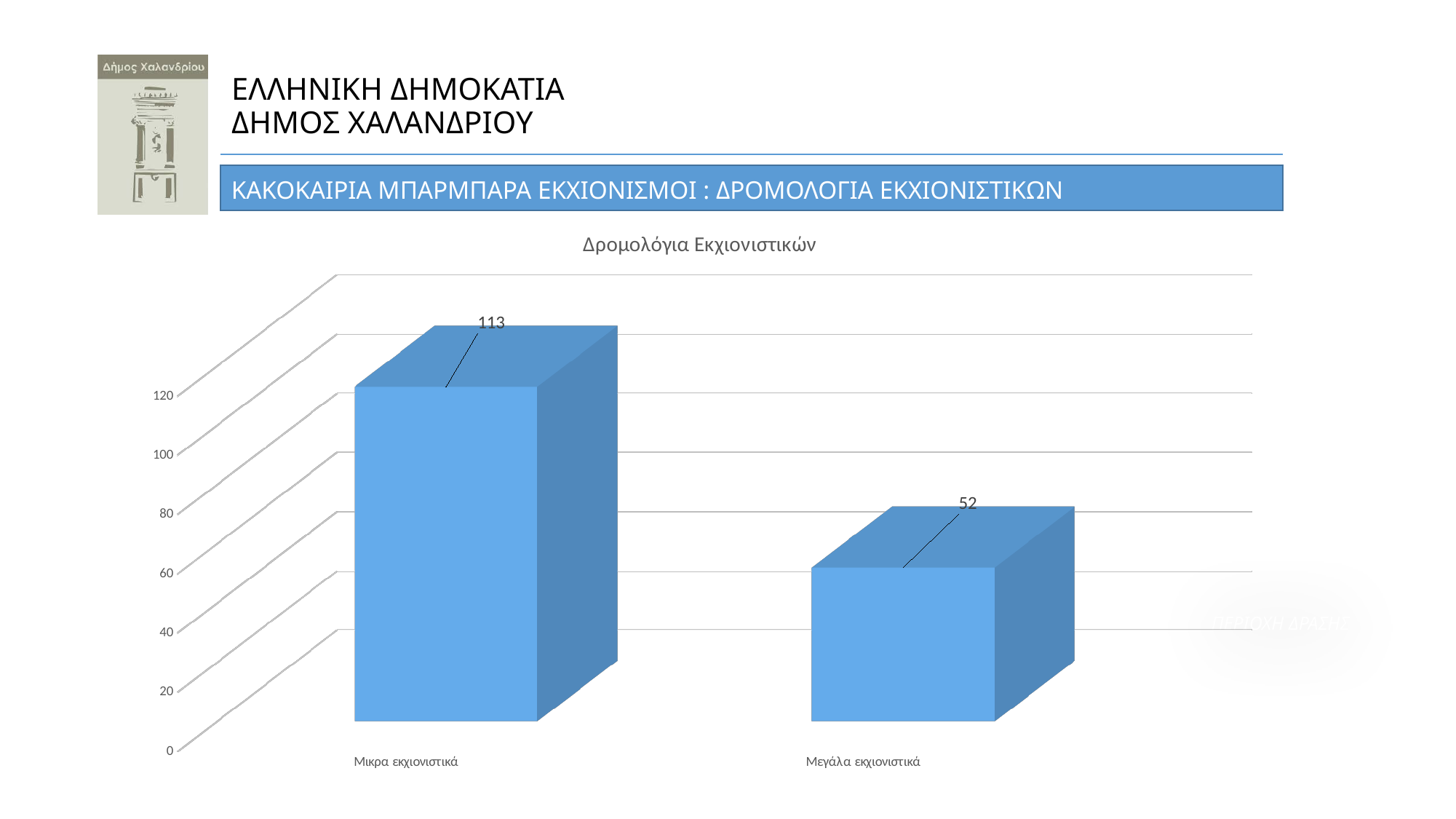
What is the value for Μικρα εκχιονιστικά? 113 What is the total of the two values shown in the chart? 165 What is the difference between the values for Μικρα εκχιονιστικά and Μεγάλα εκχιονιστικά? 61 What kind of chart is shown on the slide? bar chart Which category has the lowest value? Μεγάλα εκχιονιστικά Which category has the highest value? Μικρα εκχιονιστικά Which is larger, the value for Μικρα εκχιονιστικά or for Μεγάλα εκχιονιστικά? Μικρα εκχιονιστικά What is the title of the chart? Δρομολόγια Εκχιονιστικών How many categories are shown in the chart? 2 Is the value for Μικρα εκχιονιστικά greater or less than 100? greater Is the value for Μεγάλα εκχιονιστικά greater or less than 60? less What is the value for Μεγάλα εκχιονιστικά? 52